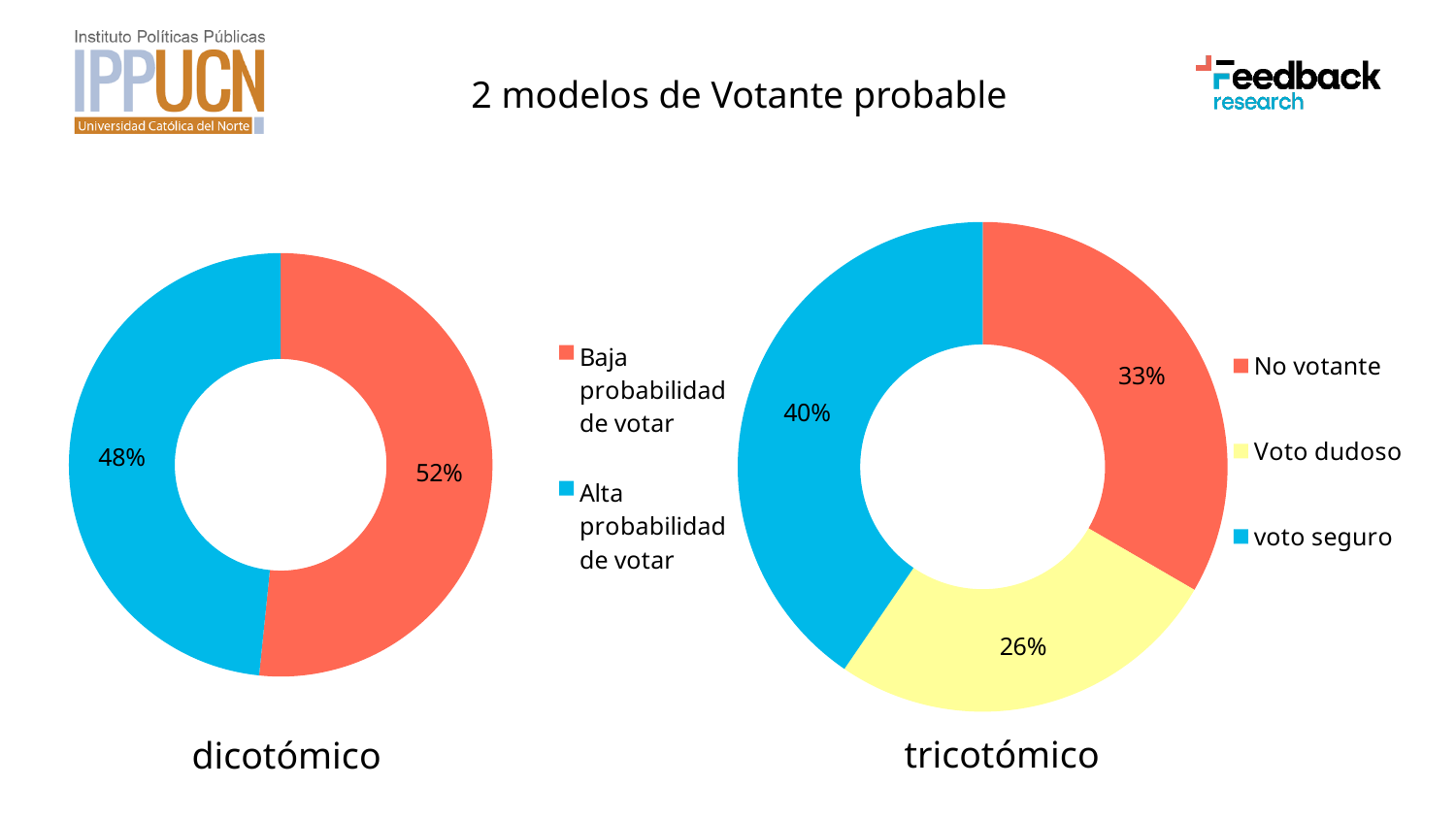
In the 'tricotómico' chart, which category has the largest share? voto seguro In the 'tricotómico' chart, which is larger: 'No votante' or 'Voto dudoso'? No votante In the 'tricotómico' chart, what percentage is shown for 'voto seguro'? 40% How many entries does the legend of the 'dicotómico' chart list? 2 In the 'dicotómico' chart, what is the difference in percentage points between 'Baja probabilidad de votar' and 'Alta probabilidad de votar'? 4 In the 'dicotómico' chart, what percentage is shown for 'Baja probabilidad de votar'? 52% In the 'tricotómico' chart, which category has the smallest share? Voto dudoso In the 'tricotómico' chart, what colour represents 'Voto dudoso'? Yellow How many categories does the 'tricotómico' chart show? 3 In the 'dicotómico' chart, what percentage is shown for 'Alta probabilidad de votar'? 48% In the 'tricotómico' chart, what percentage is shown for 'Voto dudoso'? 26% What type of chart is the 'tricotómico' chart? Doughnut chart